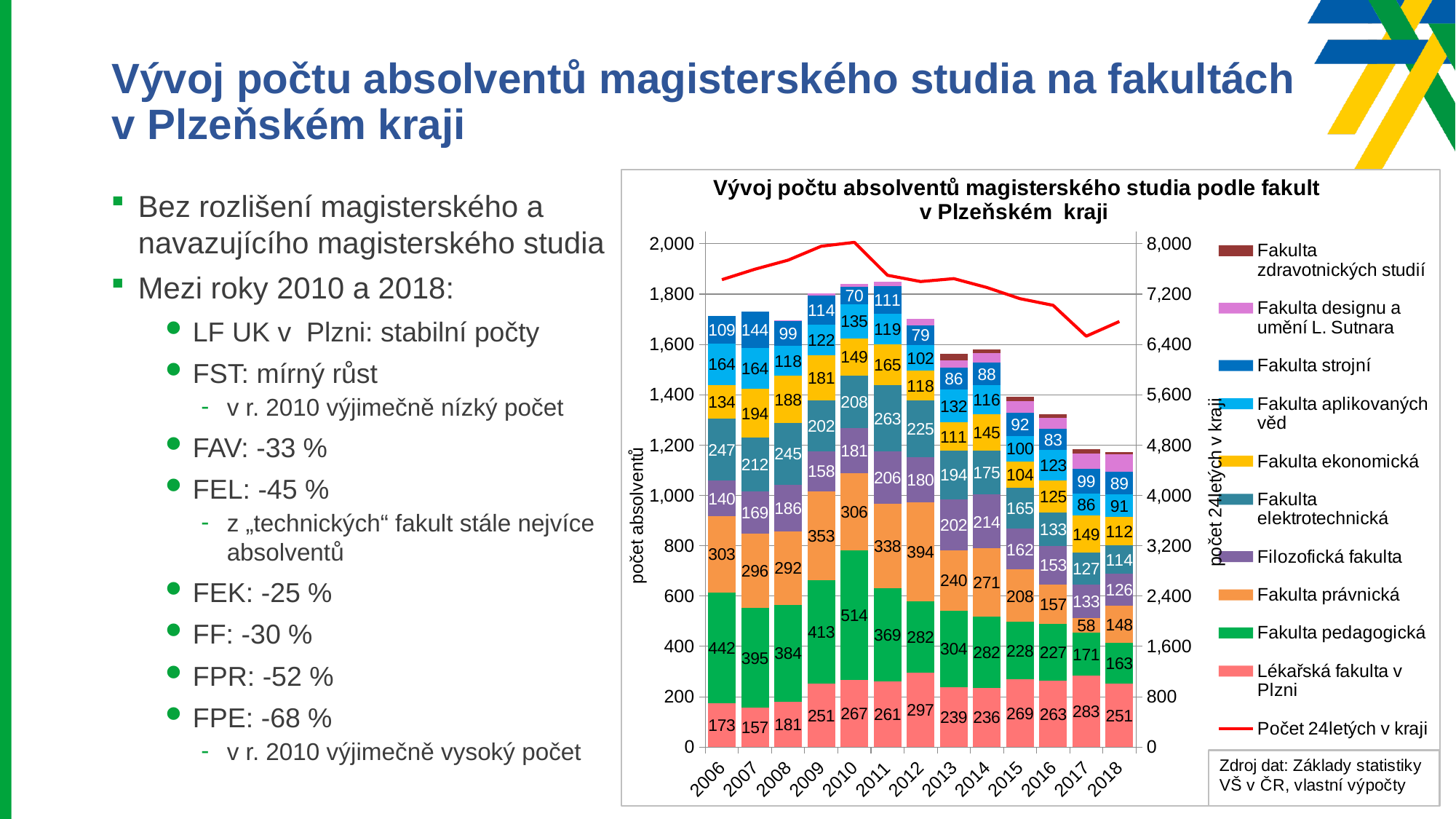
How many years are shown on the x axis? 13 In which year is the value for Fakulta právnická lowest? 2017 In which year is the value for Fakulta pedagogická highest? 2010 In 2012, which is larger: Fakulta právnická or Fakulta pedagogická? Fakulta právnická What kind of chart is this? combination stacked bar and line chart What is the difference between the Fakulta pedagogická values in 2006 and 2018? 279 What is the value for Lékařská fakulta v Plzni in 2018? 251 What is the value for Fakulta pedagogická in 2010? 514 Is the value of Počet 24letých v kraji in 2010 greater or less than 7,200? greater How many series does the legend list? 11 Does the value for Fakulta pedagogická rise or fall from 2010 to 2018? fall What is the value for Fakulta elektrotechnická in 2011? 263